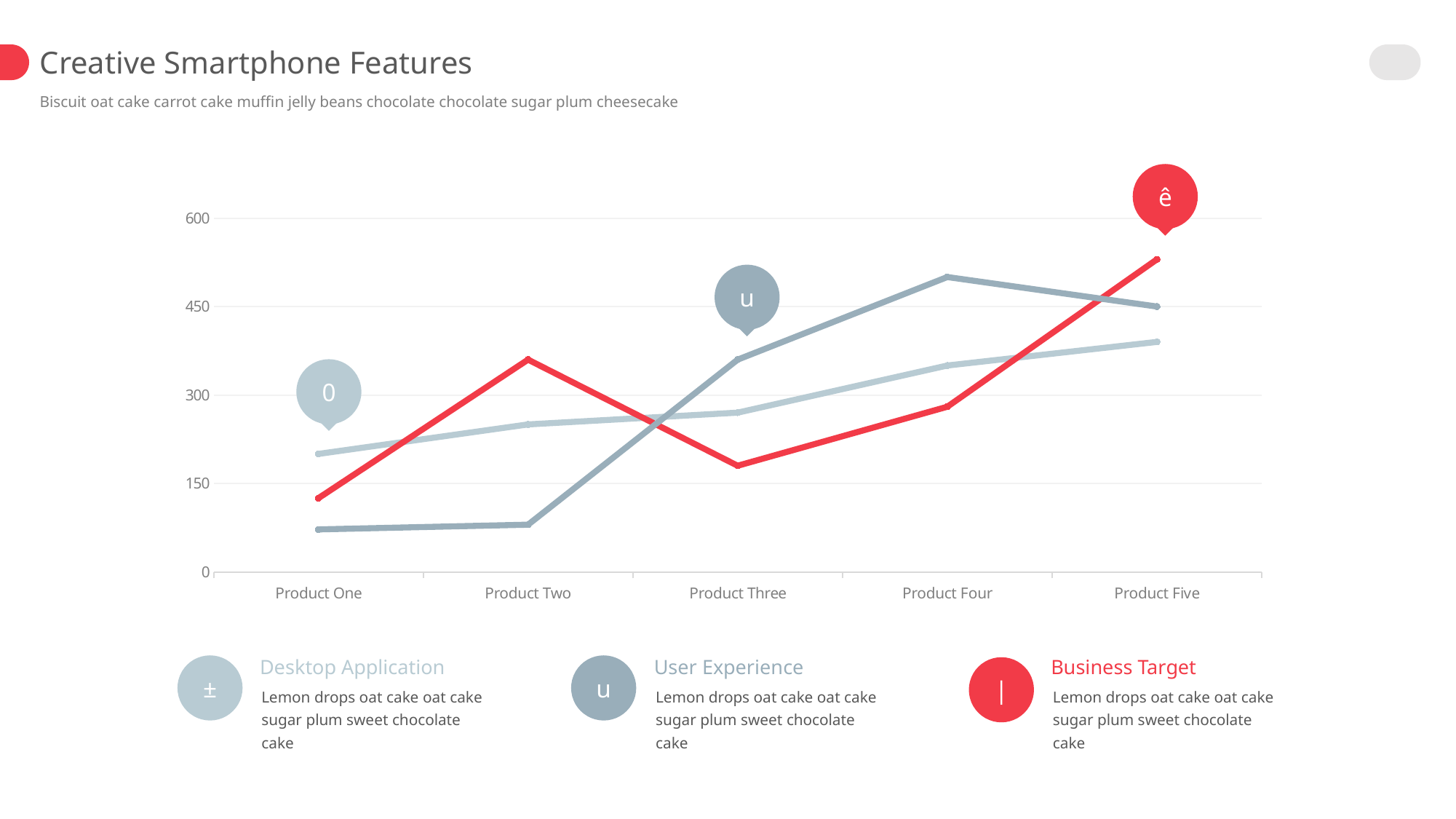
Is the value for User Experience at Product One greater or less than 150? less At which product does the Business Target series reach its highest value? Product Five Is the value for Desktop Application at Product Three greater or less than 300? less Is the value for Business Target at Product Two greater or less than 300? greater At which product does the User Experience series reach its highest value? Product Four How many series does the legend list? 3 What kind of chart is shown on the slide? line chart At Product Two, which series has the larger value: Business Target or User Experience? Business Target How many product categories are shown on the x axis? 5 Does the Desktop Application series rise or fall from Product One to Product Five? rise